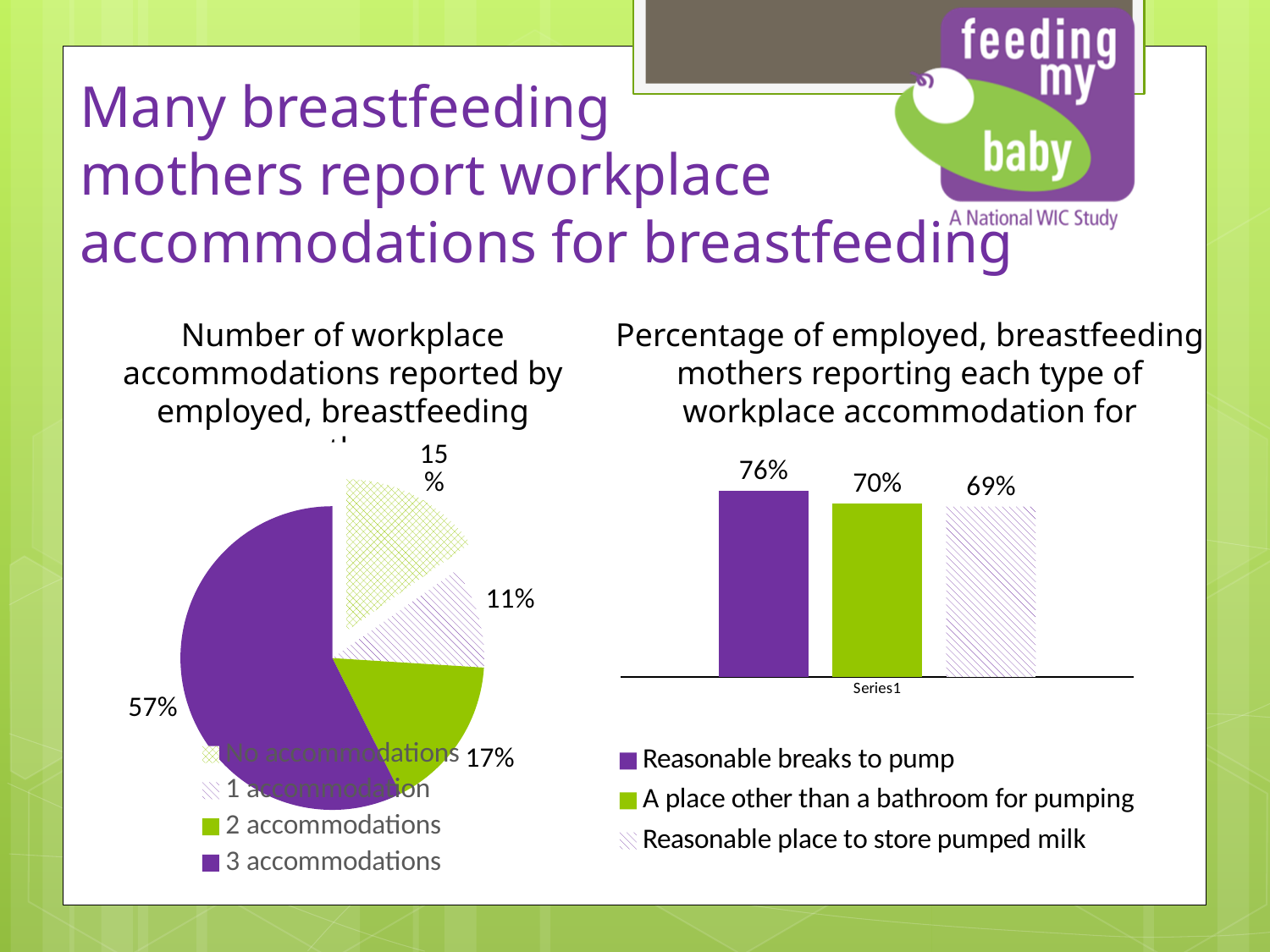
What type of chart is shown on the right side of the slide? Bar chart On the left pie chart, which category has the smallest slice? 1 accommodation On the left pie chart, what share of employed, breastfeeding mothers reported 3 accommodations? 57% On the left pie chart, which category has the largest slice? 3 accommodations On the right bar chart, how many series does the legend list? 3 On the right bar chart, what is the difference between the percentage for reasonable breaks to pump and the percentage for a place other than a bathroom for pumping? 6% On the right bar chart, what percentage of mothers reported reasonable breaks to pump? 76% On the left pie chart, what is the difference between the share for 2 accommodations and the share for 1 accommodation? 6% On the right bar chart, what percentage reported a reasonable place to store pumped milk? 69% On the left pie chart, what percentage reported no accommodations? 15% On the left pie chart, how many categories does the legend list? 4 On the right bar chart, which type of accommodation was reported by the highest percentage of mothers? Reasonable breaks to pump